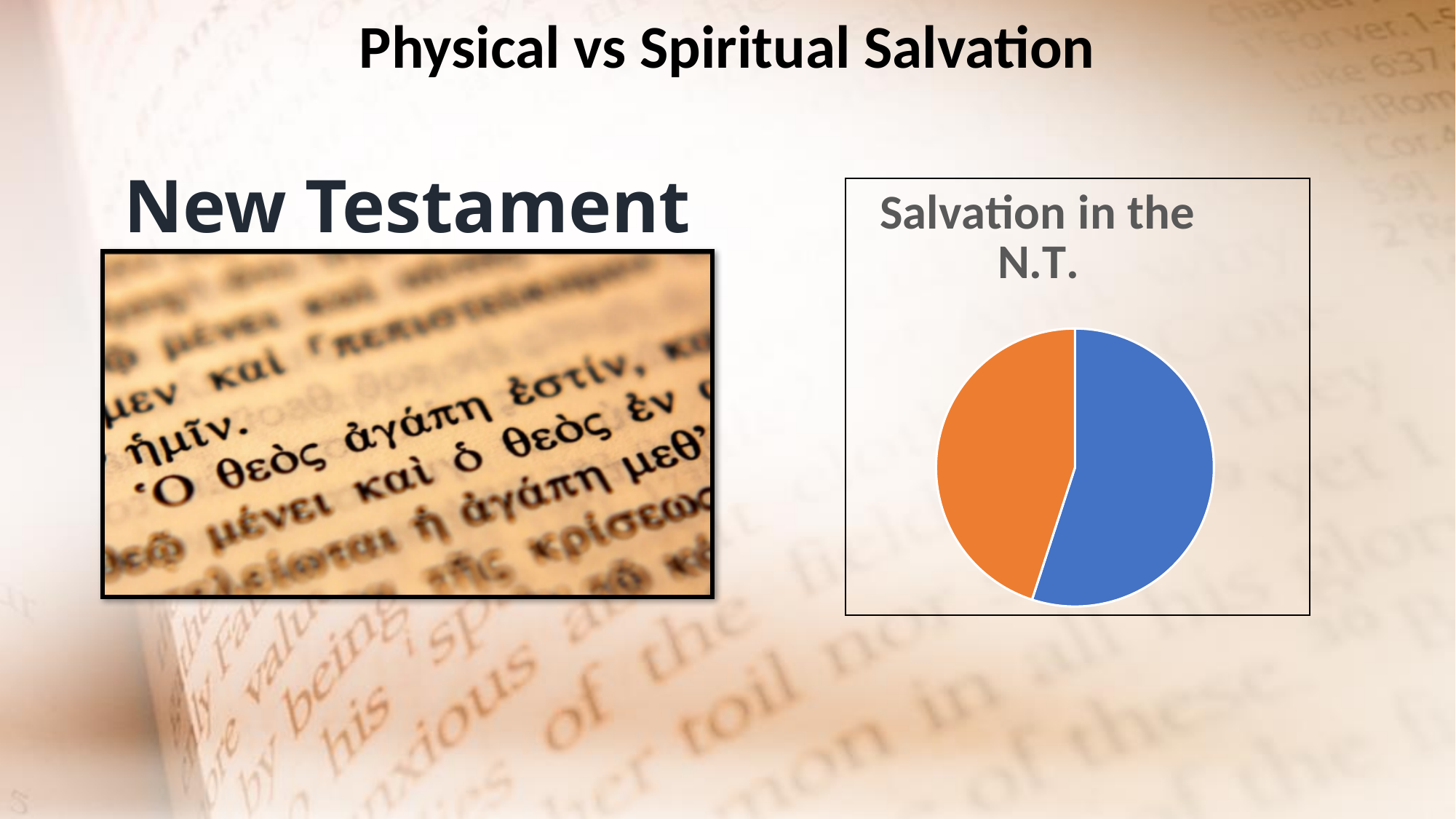
What two colours are used for the slices of the pie chart? blue and orange Does the blue slice of the pie chart take up more or less than half of the pie? more What is the title of the chart on the slide? Salvation in the N.T. What kind of chart is shown on the slide? pie chart Which slice of the pie chart is the smallest? the orange slice How many slices does the pie chart have? 2 Does the orange slice of the pie chart take up more or less than half of the pie? less Which slice of the pie chart is larger, the blue one or the orange one? blue